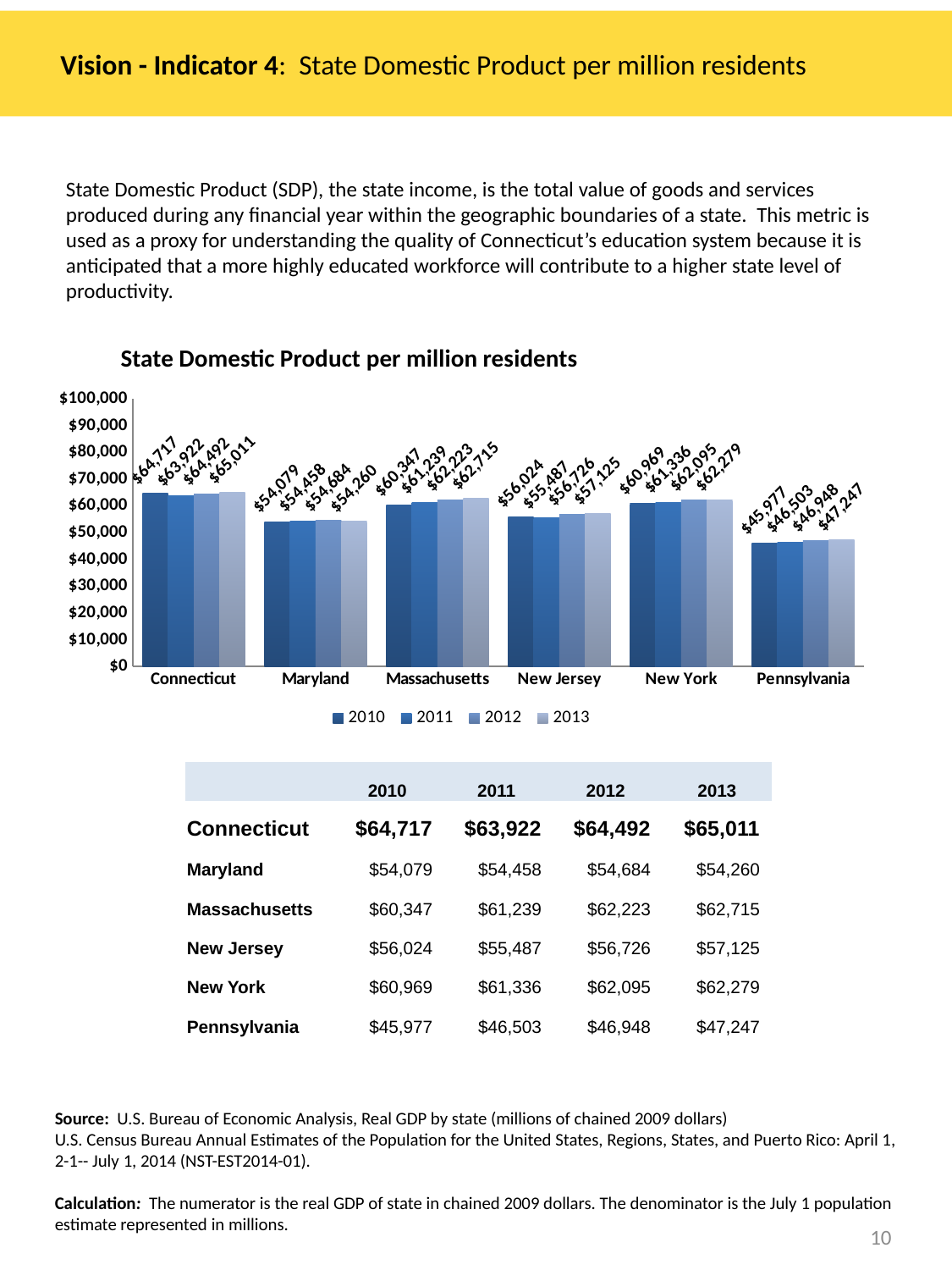
Which state has the highest State Domestic Product per million residents in 2013? Connecticut What is the difference between Connecticut's 2013 value and Pennsylvania's 2013 value? $17,764 How many states are shown on the x axis of the chart? 6 What is the State Domestic Product per million residents for Connecticut in 2013? $65,011 Is the value for Maryland in 2012 greater or less than $60,000? less What kind of chart is shown on the slide? bar chart What is the value for Pennsylvania in 2010? $45,977 Which is larger in 2012: Massachusetts or New York? Massachusetts What is the value for New Jersey in 2011? $55,487 Do Pennsylvania's values rise or fall from 2010 to 2013? rise Which state has the lowest State Domestic Product per million residents in 2010? Pennsylvania How many series does the chart legend list? 4